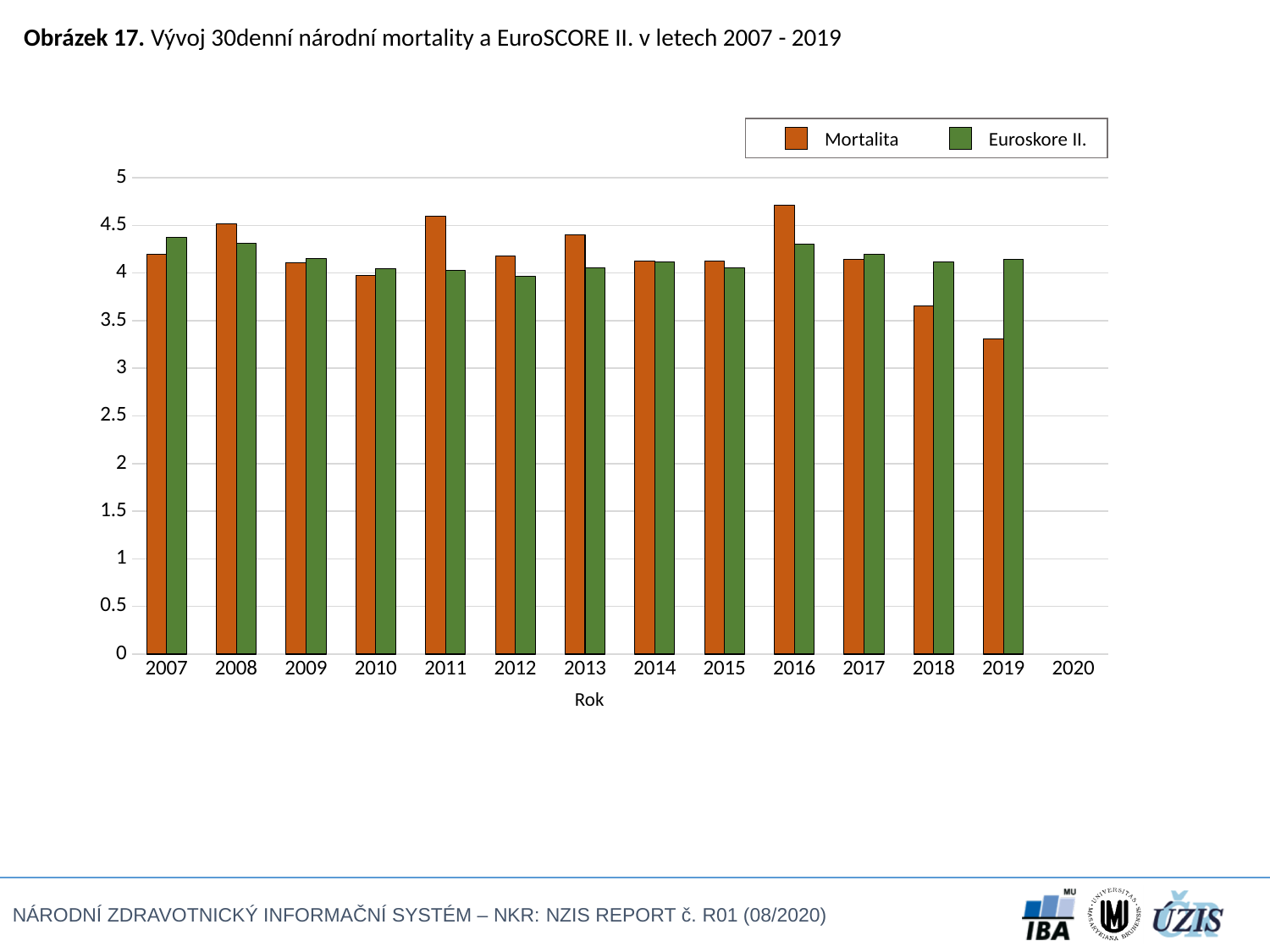
In which year is the Mortalita bar the highest? 2016 Is the Mortalita value for 2016 greater or less than 4.5? greater In which year is the Mortalita bar the lowest? 2019 What kind of chart is shown on the slide? bar chart How many series does the legend list? 2 What are the two series named in the legend? Mortalita and Euroskore II. Does the Mortalita value rise or fall from 2016 to 2019? fall In 2019, which is larger: Mortalita or Euroskore II.? Euroskore II. In 2011, which is larger: Mortalita or Euroskore II.? Mortalita Is the Euroskore II. value for 2007 greater or less than 4.5? less Is the Mortalita value for 2019 greater or less than 3.5? less